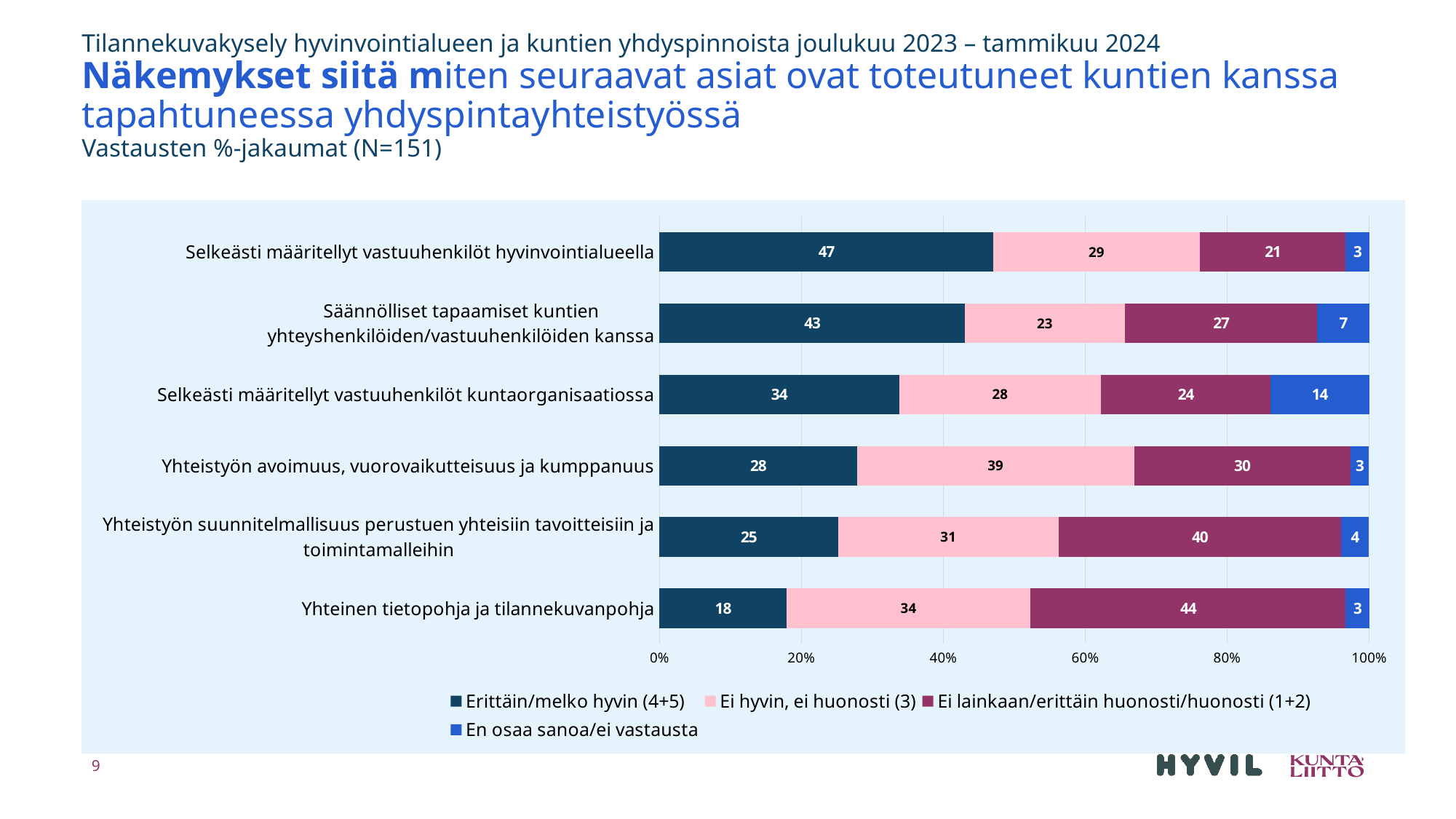
What is the sample size (N) stated in the chart subtitle? N=151 What is the value of "Ei lainkaan/erittäin huonosti/huonosti (1+2)" for "Yhteinen tietopohja ja tilannekuvanpohja"? 44 What is the value of "En osaa sanoa/ei vastausta" for "Selkeästi määritellyt vastuuhenkilöt kuntaorganisaatiossa"? 14 How many series does the legend list? 4 Which is larger: the "Ei hyvin, ei huonosti (3)" value for "Yhteistyön avoimuus, vuorovaikutteisuus ja kumppanuus" or for "Säännölliset tapaamiset kuntien yhteyshenkilöiden/vastuuhenkilöiden kanssa"? Yhteistyön avoimuus, vuorovaikutteisuus ja kumppanuus What is the value of "Erittäin/melko hyvin (4+5)" for "Selkeästi määritellyt vastuuhenkilöt hyvinvointialueella"? 47 How many categories are shown on the chart? 6 What kind of chart is shown on the slide? Stacked bar chart Which category has the highest value for "Erittäin/melko hyvin (4+5)"? Selkeästi määritellyt vastuuhenkilöt hyvinvointialueella What is the total of the stacked bar for "Säännölliset tapaamiset kuntien yhteyshenkilöiden/vastuuhenkilöiden kanssa"? 100 What is the difference between the "Ei lainkaan/erittäin huonosti/huonosti (1+2)" values for "Yhteinen tietopohja ja tilannekuvanpohja" and "Selkeästi määritellyt vastuuhenkilöt hyvinvointialueella"? 23 Which category has the lowest value for "Erittäin/melko hyvin (4+5)"? Yhteinen tietopohja ja tilannekuvanpohja